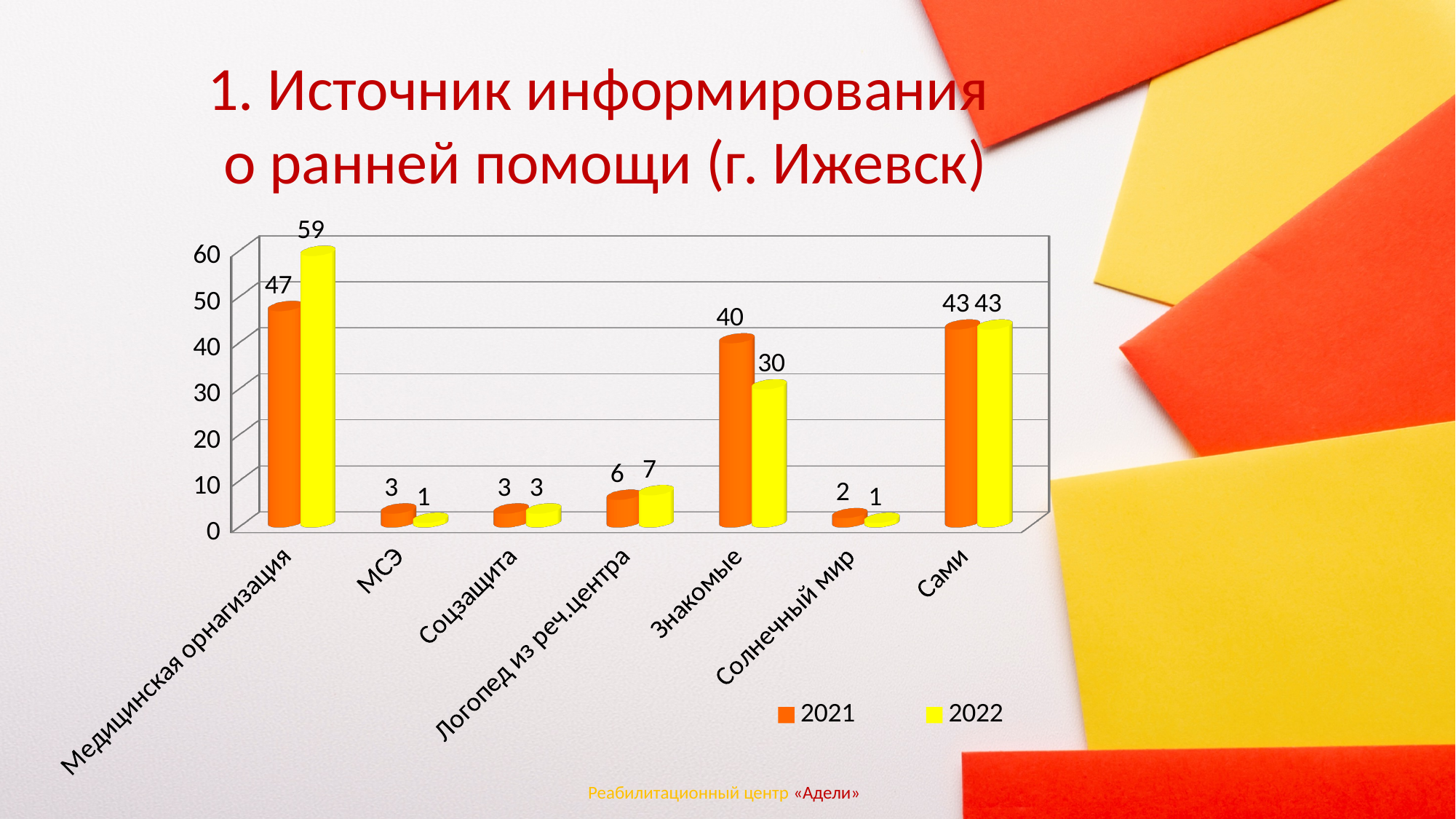
How many series does the legend list? 2 Which category has the highest value for 2021? Медицинская орнагизация What is the value for 2021 for Знакомые? 40 Which category has the lowest value for 2022? МСЭ and Солнечный мир (both 1) Which is larger for Знакомые, the 2021 value or the 2022 value? 2021 What kind of chart is shown on the slide? Bar chart How many categories are shown on the x axis? 7 What is the value for 2021 for Солнечный мир? 2 What is the value for 2022 for Логопед из реч.центра? 7 What is the difference between the 2022 and 2021 values for Медицинская орнагизация? 12 What is the value for 2022 for Медицинская орнагизация? 59 What is the difference between the 2021 and 2022 values for Знакомые? 10